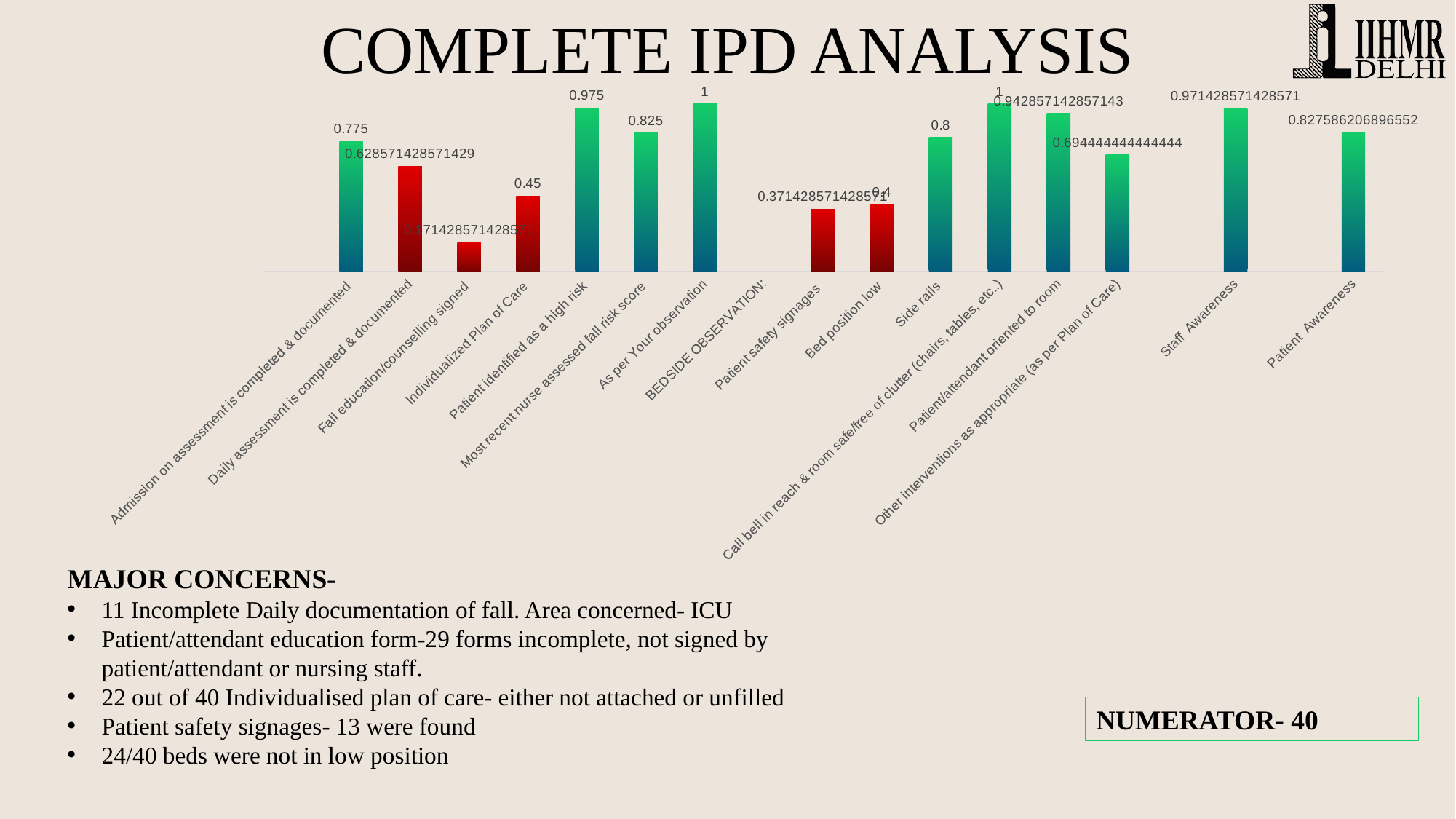
How many bars are shown in red on the chart? 5 What is the value for 'Patient identified as a high risk'? 0.975 What is the value for 'Bed position low'? 0.4 What is the difference between the values for 'Patient identified as a high risk' and 'Admission on assessment is completed & documented'? 0.2 Which is larger, the value for 'Staff Awareness' or the value for 'Patient Awareness'? Staff Awareness What is the value for 'Patient Awareness'? 0.827586206896552 What is the value for 'Individualized Plan of Care'? 0.45 What kind of chart is shown on the slide? Bar chart What is the difference between the values for 'Side rails' and 'Bed position low'? 0.4 What is the value for 'Side rails'? 0.8 What is the value for 'Staff Awareness'? 0.971428571428571 What is the value for 'Admission on assessment is completed & documented'? 0.775